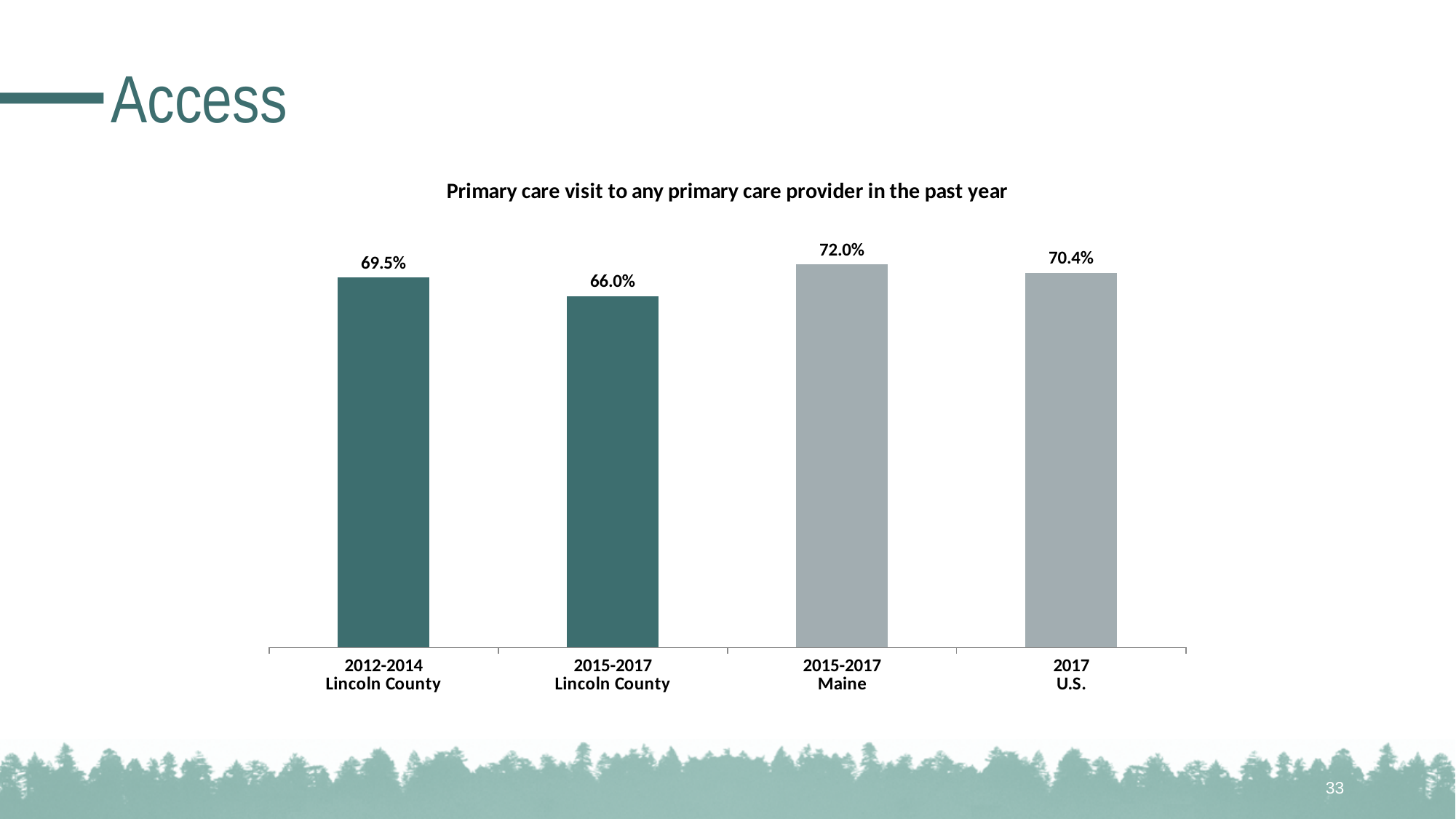
Which is larger, the value for 2017 U.S. or the value for 2012-2014 Lincoln County? 2017 U.S. What is the difference between the 2012-2014 Lincoln County value and the 2015-2017 Lincoln County value? 3.5% What is the value for 2015-2017 Maine? 72.0% How many bars are shown in the chart? 4 What is the difference between the 2015-2017 Maine value and the 2015-2017 Lincoln County value? 6.0% What is the value for 2012-2014 Lincoln County? 69.5% Which category has the highest value? 2015-2017 Maine Which category has the lowest value? 2015-2017 Lincoln County What kind of chart is shown on the slide? Bar chart What is the value for 2017 U.S.? 70.4% What is the title of the chart? Primary care visit to any primary care provider in the past year What is the value for 2015-2017 Lincoln County? 66.0%